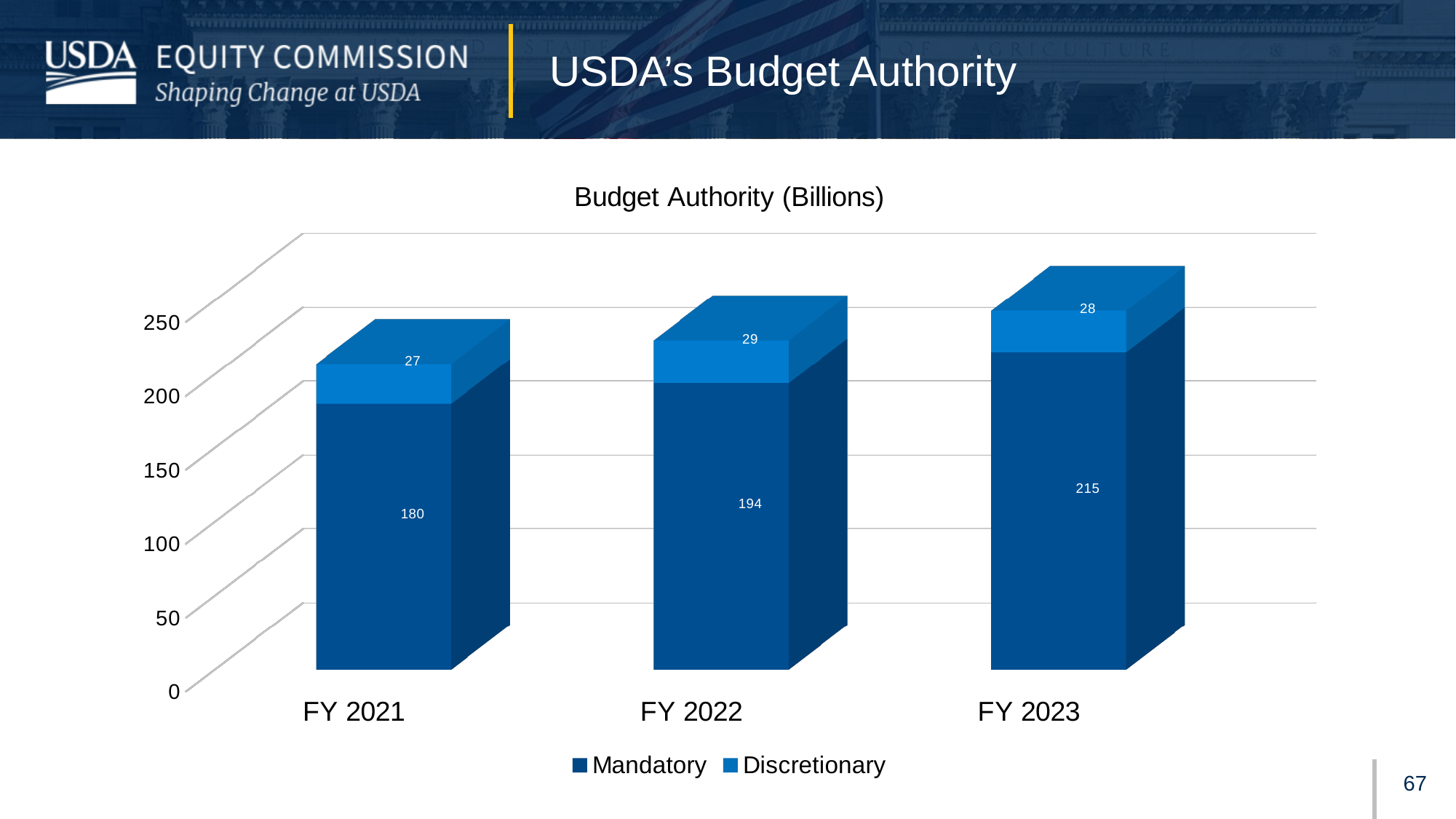
What is the Mandatory value for FY 2021? 180 What kind of chart is shown on the slide? Stacked bar chart What is the difference between the Mandatory values for FY 2023 and FY 2021? 35 Which fiscal year has the highest Mandatory value? FY 2023 How many series does the legend list? 2 What is the Mandatory value for FY 2023? 215 Is the Discretionary value larger in FY 2022 or FY 2023? FY 2022 Which fiscal year has the lowest Discretionary value? FY 2021 How many fiscal years are shown on the x axis? 3 Do the Mandatory values rise or fall from FY 2021 to FY 2023? Rise What is the total of the stacked bar for FY 2022? 223 What is the Discretionary value for FY 2022? 29